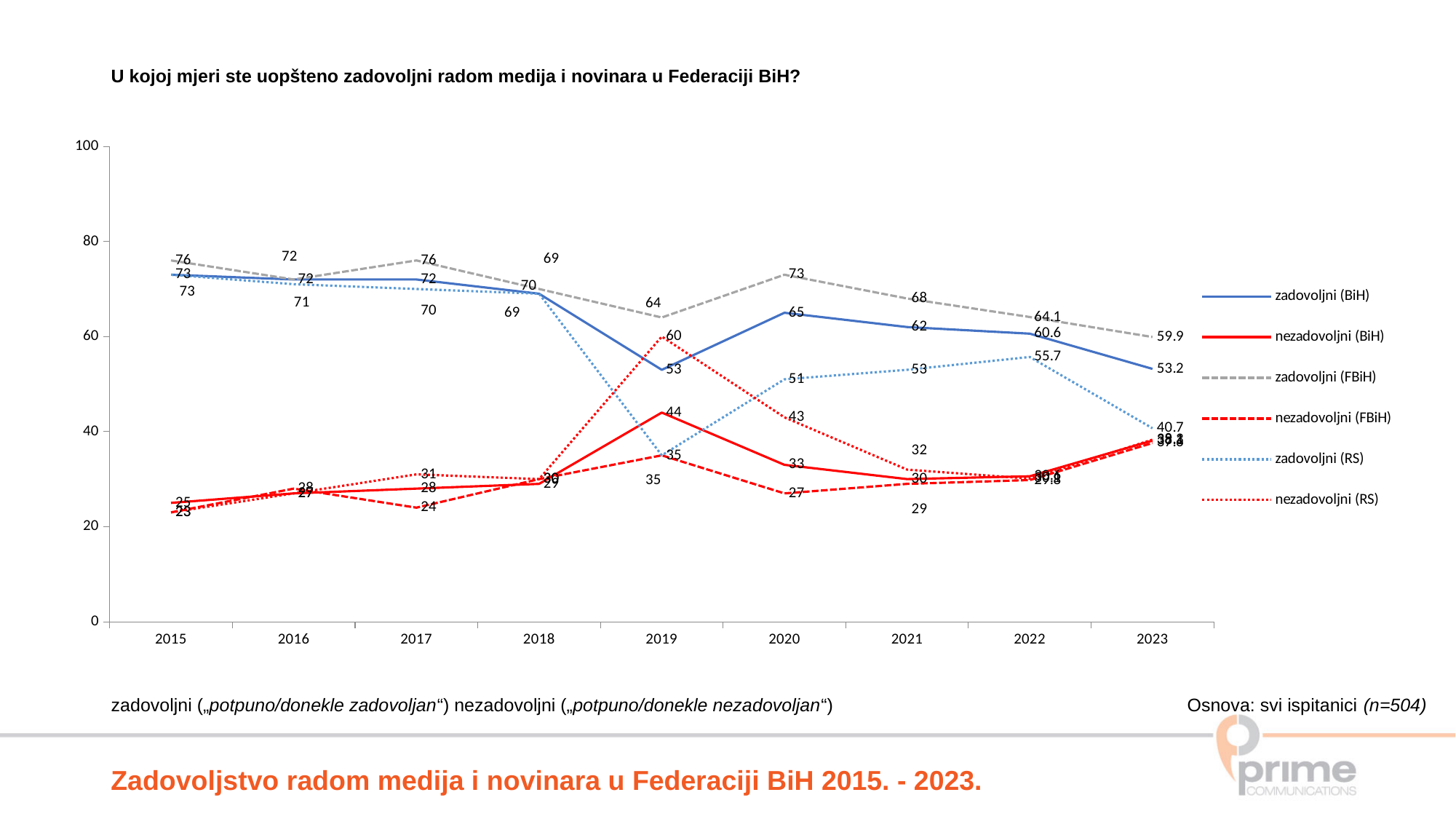
What is the value for zadovoljni (BiH) in 2023? 53.2 In which year does nezadovoljni (RS) reach its highest value? 2019 What is the difference between the zadovoljni (FBiH) values for 2015 and 2023? 16.1 What is the value for zadovoljni (FBiH) in 2023? 59.9 In which year does zadovoljni (RS) reach its lowest value? 2019 How many years are plotted along the x axis? 9 How many series does the legend list? 6 What is the value for nezadovoljni (RS) in 2019? 60 What is the value for zadovoljni (RS) in 2022? 55.7 What kind of chart is shown on the slide? line chart Is the value for zadovoljni (RS) in 2020 greater or less than 60? less In 2019, which is larger: zadovoljni (BiH) or nezadovoljni (RS)? nezadovoljni (RS)